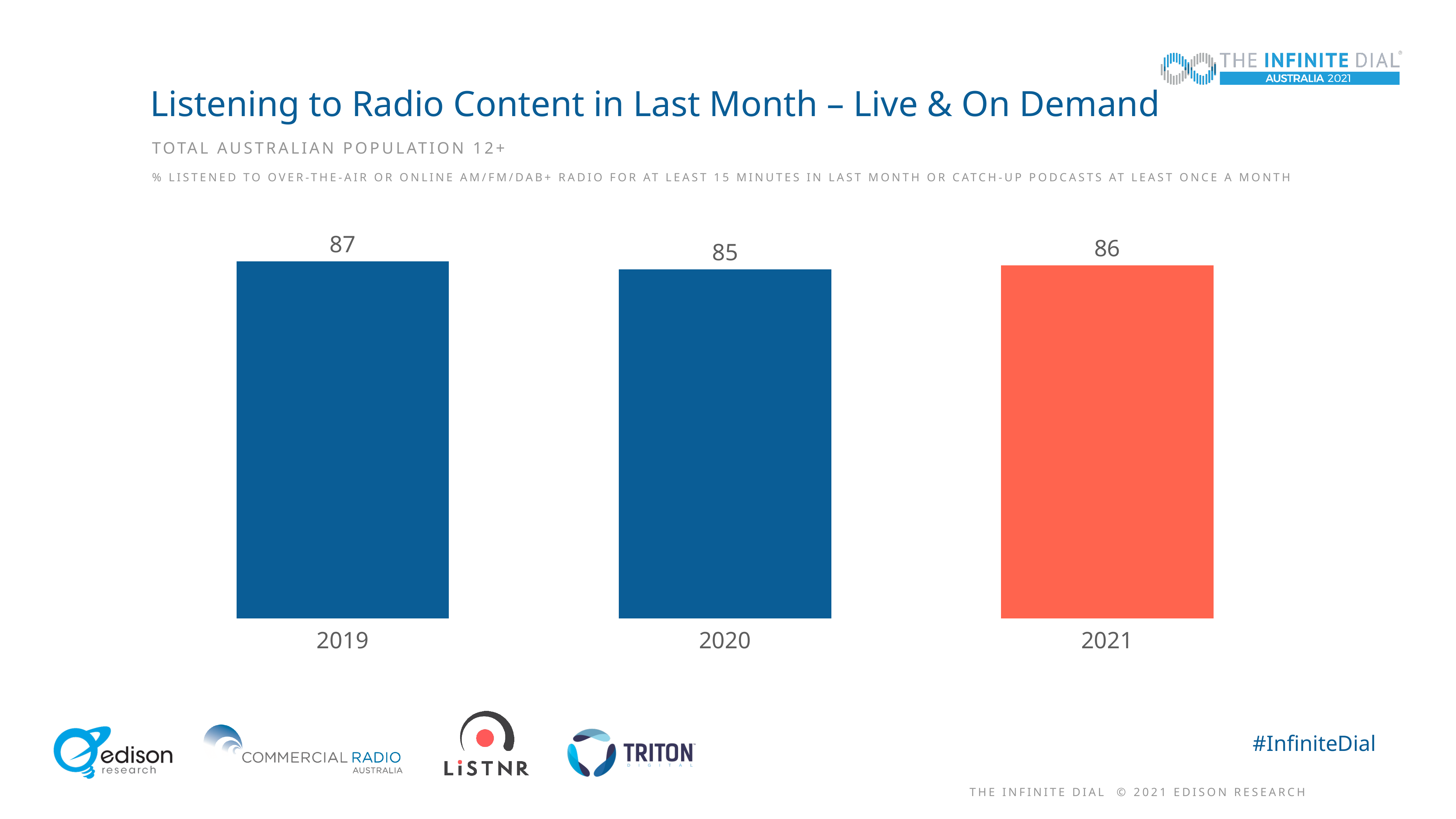
What is the value for 2020? 85 How many years are shown in the chart? 3 What is the difference between the values for 2021 and 2020? 1 Which year has the lowest value? 2020 Which is larger, the value for 2019 or the value for 2021? 2019 Which year's bar is coloured red-orange rather than blue? 2021 Does the value rise or fall from 2020 to 2021? Rise Which year has the highest value? 2019 What is the value for 2021? 86 What is the value for 2019? 87 What is the difference between the values for 2019 and 2020? 2 What kind of chart is shown on the slide? Bar chart